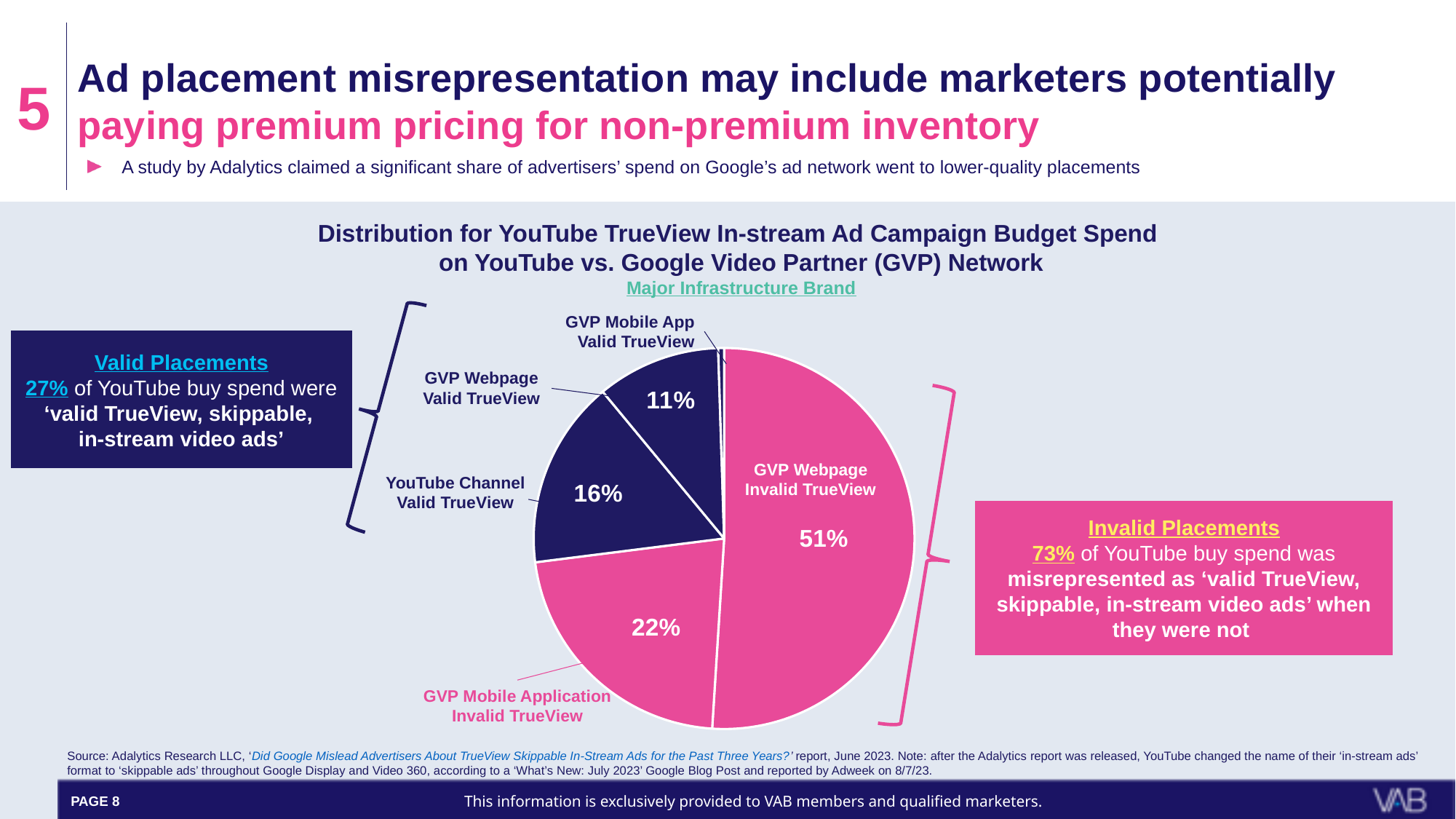
Which slice of the pie is the largest? GVP Webpage Invalid TrueView What share of the budget spend went to GVP Webpage Valid TrueView? 11% Which is larger, the YouTube Channel Valid TrueView slice or the GVP Webpage Valid TrueView slice? YouTube Channel Valid TrueView Which slice of the pie is the smallest? GVP Mobile App Valid TrueView What share of the budget spend went to GVP Mobile Application Invalid TrueView? 22% How many slices does the pie chart have? 5 What share of the budget spend went to GVP Webpage Invalid TrueView? 51% What is the combined share of the two Invalid TrueView slices? 73% Which brand's campaign does the pie chart represent, according to the subtitle? Major Infrastructure Brand What share of the budget spend went to YouTube Channel Valid TrueView? 16% What is the difference in percentage points between the GVP Webpage Invalid TrueView slice and the GVP Mobile Application Invalid TrueView slice? 29 percentage points What kind of chart is shown on the slide? Pie chart